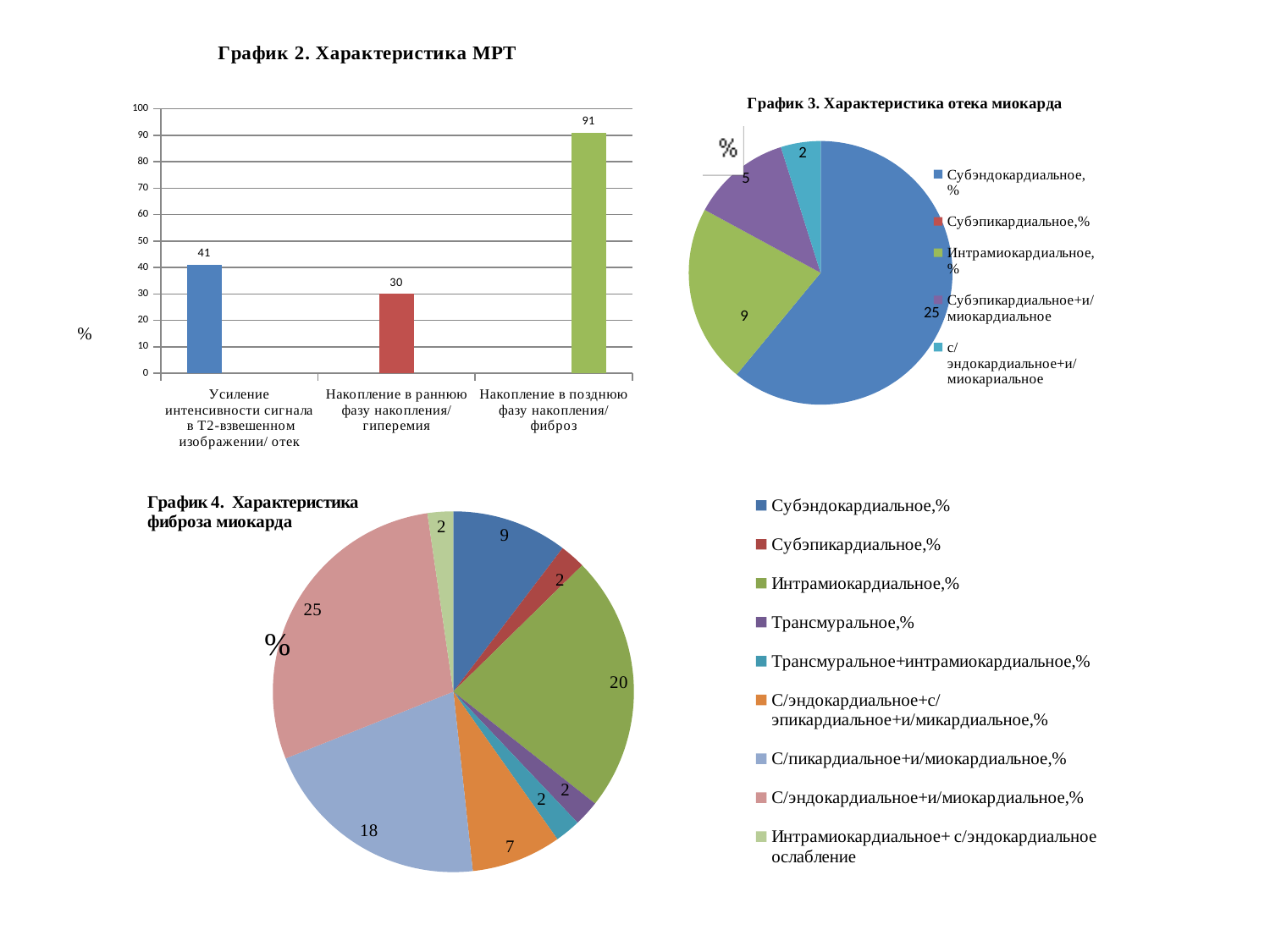
In the chart 'График 4. Характеристика фиброза миокарда', which is larger: 'Интрамиокардиальное' or 'С/пикардиальное+и/миокардиальное'? Интрамиокардиальное What kind of chart is 'График 2. Характеристика МРТ'? bar chart In the chart 'График 2. Характеристика МРТ', what is the value for 'Накопление в позднюю фазу накопления/ фиброз'? 91 In the chart 'График 4. Характеристика фиброза миокарда', what is the value for 'С/эндокардиальное+и/миокардиальное'? 25 In the chart 'График 3. Характеристика отека миокарда', which category has the largest slice? Субэндокардиальное In the chart 'График 2. Характеристика МРТ', which category has the lowest value? Накопление в раннюю фазу накопления/ гиперемия How many categories are shown in the chart 'График 2. Характеристика МРТ'? 3 In the chart 'График 2. Характеристика МРТ', which category has the highest value? Накопление в позднюю фазу накопления/ фиброз In the chart 'График 2. Характеристика МРТ', what is the difference between the value for 'фиброз' and the value for 'отек'? 50 In the chart 'График 3. Характеристика отека миокарда', what is the value for 'Интрамиокардиальное'? 9 How many entries does the legend of the chart 'График 3. Характеристика отека миокарда' list? 5 How many entries does the legend of the chart 'График 4. Характеристика фиброза миокарда' list? 9